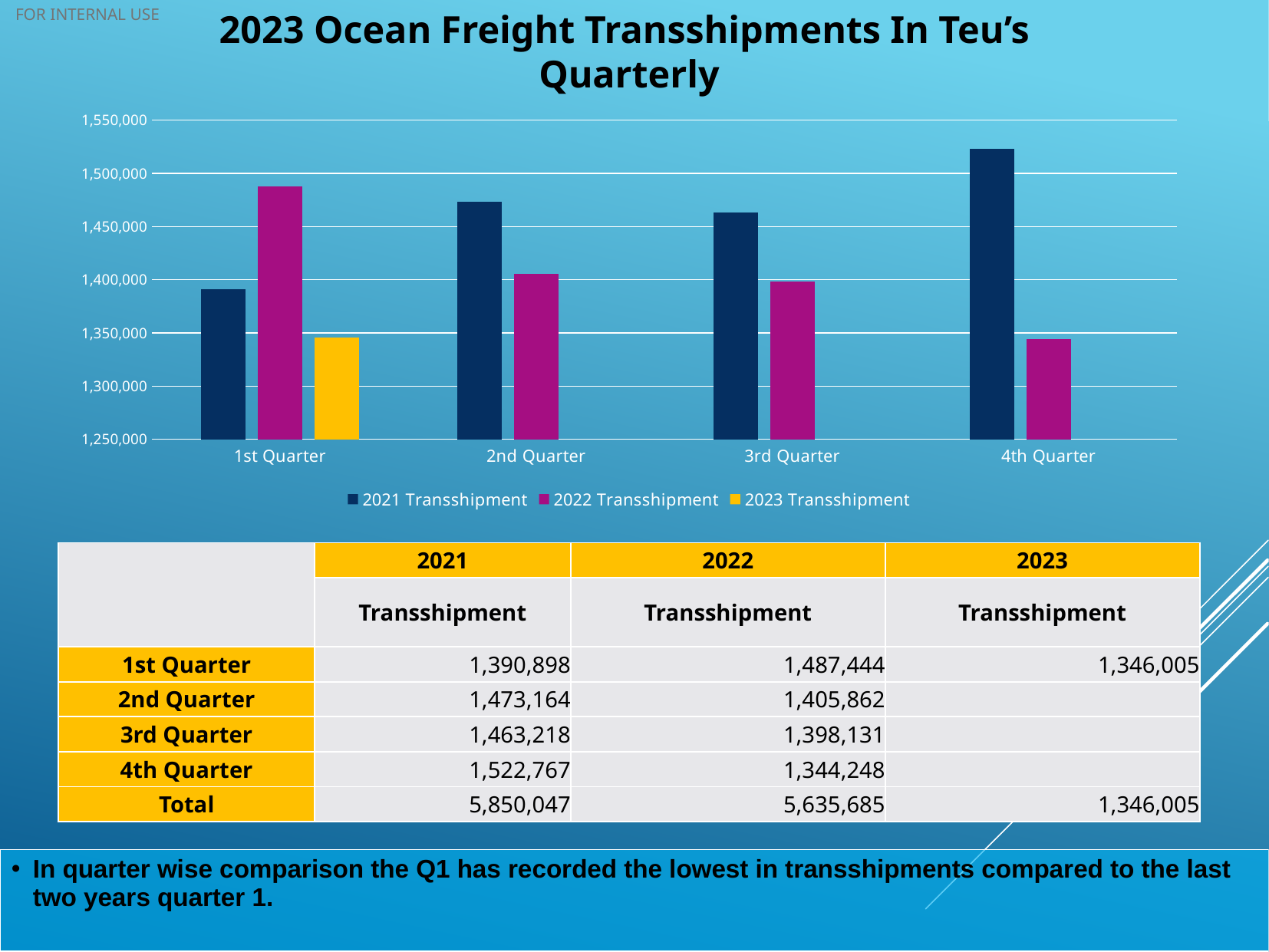
How many series does the chart legend list? 3 What is the difference between the 2021 and 2022 Transshipment values for the 4th Quarter? 178,519 Is the 2021 Transshipment value for the 1st Quarter greater or less than 1,400,000? less What kind of chart is shown on the slide? bar chart Do the 2022 Transshipment values rise or fall from the 1st Quarter to the 4th Quarter? fall Which quarter has the highest 2021 Transshipment value? 4th Quarter How many quarters are shown on the x axis of the chart? 4 Which is larger in the 2nd Quarter, the 2021 Transshipment or the 2022 Transshipment? 2021 Transshipment Which quarter has the lowest 2022 Transshipment value? 4th Quarter What is the 2021 Transshipment value for the 4th Quarter? 1,522,767 What is the 2022 Transshipment value for the 1st Quarter? 1,487,444 What is the 2023 Transshipment value for the 1st Quarter? 1,346,005